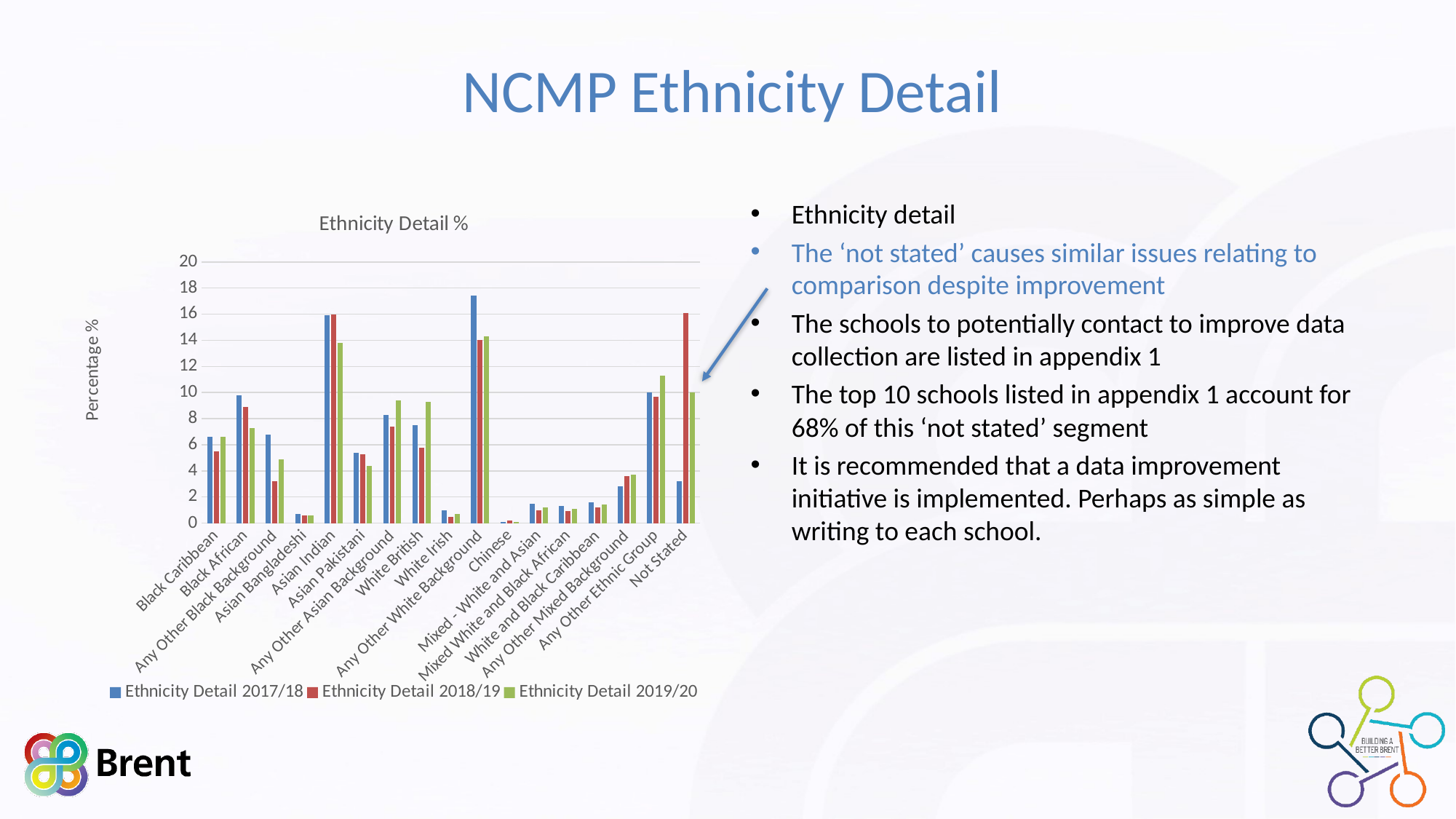
What is the label on the vertical axis of the chart? Percentage % For Any Other Asian Background, which is larger: the Ethnicity Detail 2018/19 value or the Ethnicity Detail 2019/20 value? Ethnicity Detail 2019/20 What type of chart is shown on the slide? Bar chart How many series does the chart legend list? 3 How many ethnicity categories are shown on the x axis of the chart? 17 Which category has the lowest values across all three series? Chinese Which category has the highest value for Ethnicity Detail 2017/18? Any Other White Background Is the Ethnicity Detail 2017/18 value for Any Other White Background greater or less than 16? greater Is the Ethnicity Detail 2018/19 value for Not Stated greater or less than 14? greater What is the title of the chart? Ethnicity Detail % For Not Stated, which series has the larger value: Ethnicity Detail 2017/18 or Ethnicity Detail 2018/19? Ethnicity Detail 2018/19 Is the Ethnicity Detail 2017/18 value for Asian Bangladeshi greater or less than 2? less